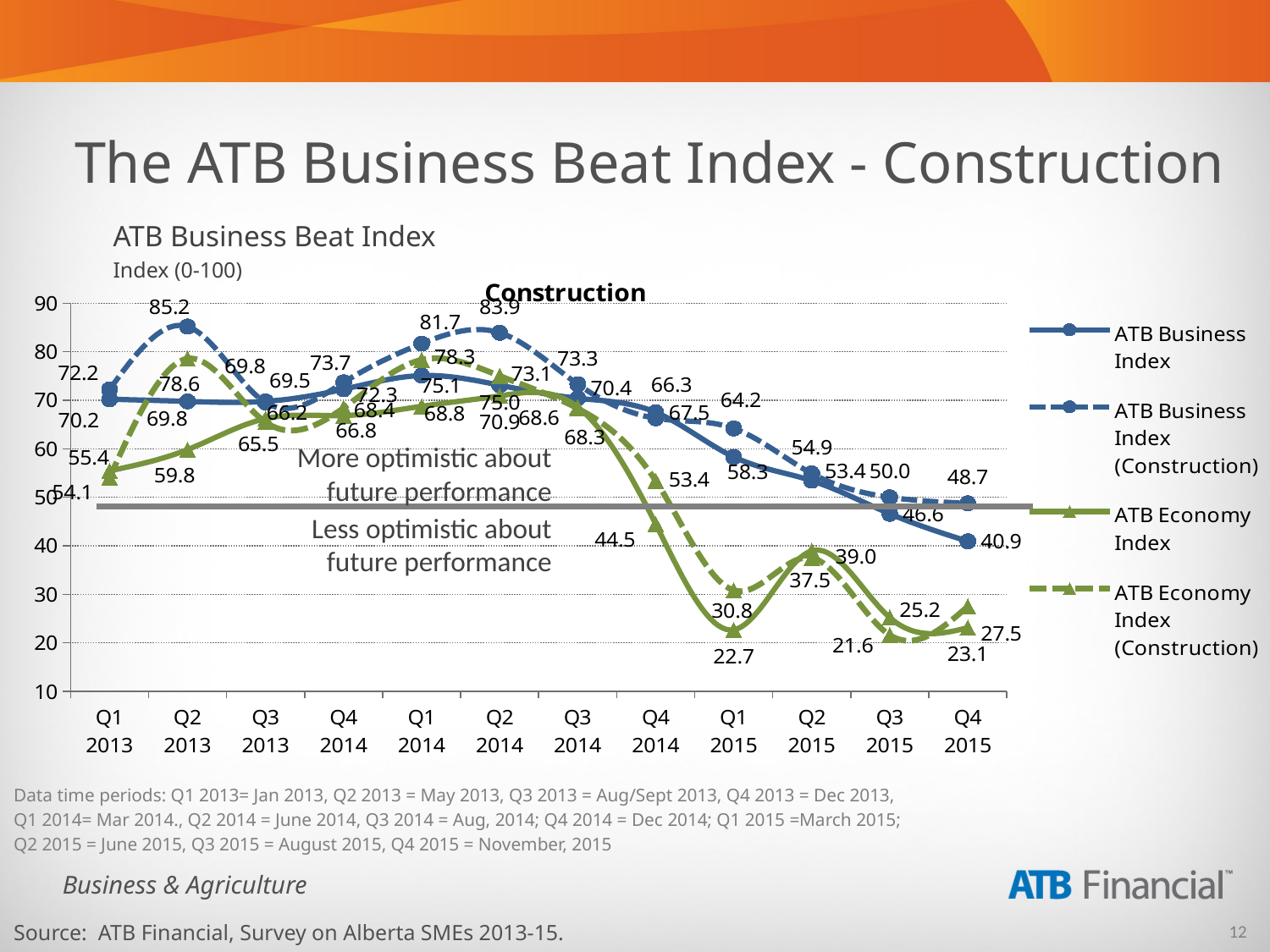
What is the value of the ATB Economy Index (Construction) in Q4 2015? 27.5 In Q1 2015, which is larger: the ATB Business Index (Construction) or the ATB Business Index? ATB Business Index (Construction) What is the lowest value of the ATB Economy Index series, and in which quarter does it occur? 22.7 in Q1 2015 How many quarters are plotted along the x axis? 12 Is the ATB Economy Index (Construction) value in Q1 2015 greater or less than 40? less What is the highest value of the ATB Business Index (Construction) series, and in which quarter does it occur? 85.2 in Q2 2013 What kind of chart is shown on the slide? line chart What is the value of the ATB Business Index (Construction) in Q4 2015? 48.7 How many series does the legend list? 4 Does the ATB Business Index rise or fall from Q3 2014 to Q4 2015? fall What is the difference between the ATB Business Index (Construction) and the ATB Business Index in Q4 2015? 7.8 What is the value of the ATB Business Index in Q4 2015? 40.9